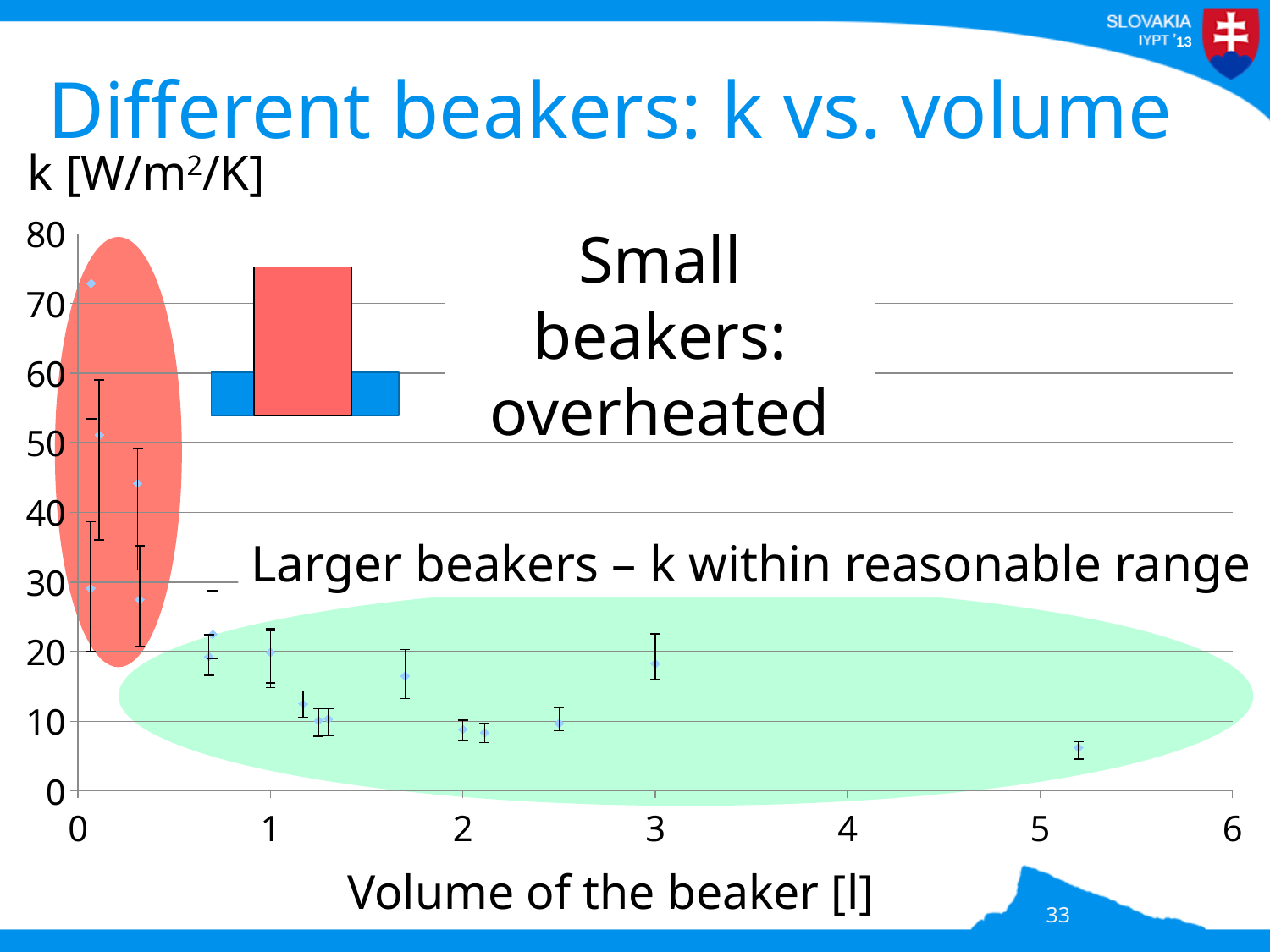
Is the value of k for the beaker with a volume of about 5.2 l greater or less than 10? less Is the highest plotted value of k greater or less than 70? greater What kind of chart is shown on the slide? scatter chart Roughly at which beaker volume does the lowest value of k occur: near 0 l or near 5 l? near 5 l Roughly at which beaker volume does the highest value of k occur: near 0 l or near 5 l? near 0 l What is the title of the chart on the slide? Different beakers: k vs. volume What quantity is plotted on the x axis of the chart? Volume of the beaker [l] Is the value of k for the beaker with a volume of about 1.7 l greater or less than 20? less Which has the larger value of k: the beaker with a volume of about 0.3 l or the beaker with a volume of about 1.7 l? the beaker with a volume of about 0.3 l Do the values of k generally rise or fall as the beaker volume increases? fall Which has the larger value of k: the beaker with a volume of about 3 l or the beaker with a volume of about 5.2 l? the beaker with a volume of about 3 l